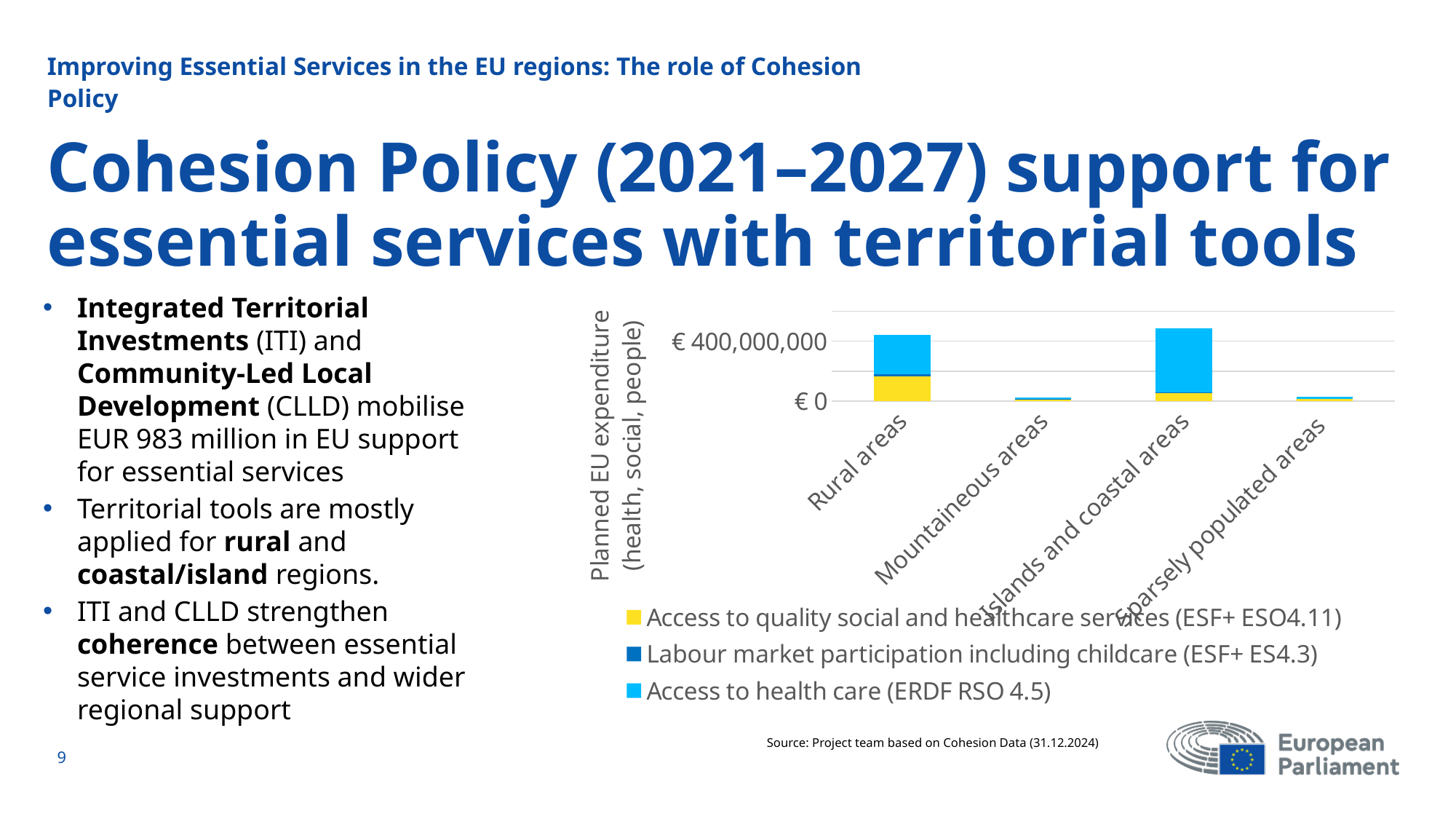
Is the total planned EU expenditure for Mountaineous areas greater or less than € 400,000,000? less Which has a larger total planned EU expenditure, Rural areas or Mountaineous areas? Rural areas Is the total planned EU expenditure for Islands and coastal areas greater or less than € 400,000,000? greater Which legend entry is shown in yellow? Access to quality social and healthcare services (ESF+ ESO4.11) What kind of chart is shown on the slide? Stacked bar chart Which category has the larger 'Access to health care (ERDF RSO 4.5)' segment, Rural areas or Islands and coastal areas? Islands and coastal areas How many categories (area types) are shown on the x axis of the chart? 4 What is the label of the chart's vertical axis? Planned EU expenditure (health, social, people) How many series does the chart's legend list? 3 Which category has the larger 'Access to quality social and healthcare services (ESF+ ESO4.11)' segment, Rural areas or Islands and coastal areas? Rural areas Is the total planned EU expenditure for Sparsely populated areas greater or less than € 400,000,000? less